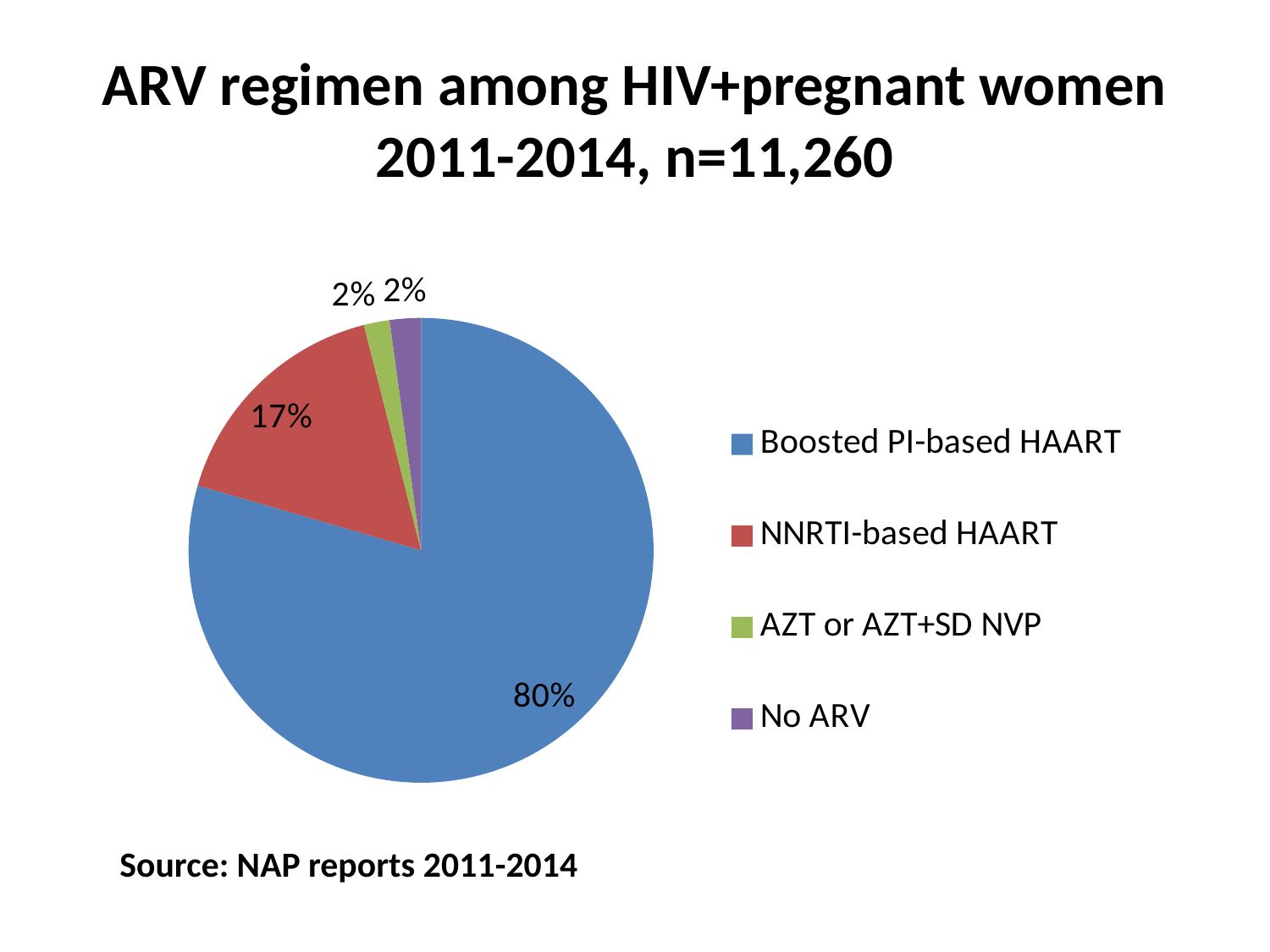
What is the combined share of NNRTI-based HAART and No ARV? 19% What share of the pie does NNRTI-based HAART represent? 17% What share of the pie does AZT or AZT+SD NVP represent? 2% Which category has the largest slice of the pie? Boosted PI-based HAART What is the difference in percentage points between Boosted PI-based HAART and NNRTI-based HAART? 63 What is the title of the chart? ARV regimen among HIV+pregnant women 2011-2014, n=11,260 Which is larger, the share for NNRTI-based HAART or the share for No ARV? NNRTI-based HAART What kind of chart is shown on the slide? Pie chart What share of the pie does No ARV represent? 2% How many categories are shown in the pie chart? 4 Which colour represents NNRTI-based HAART in the legend? Red